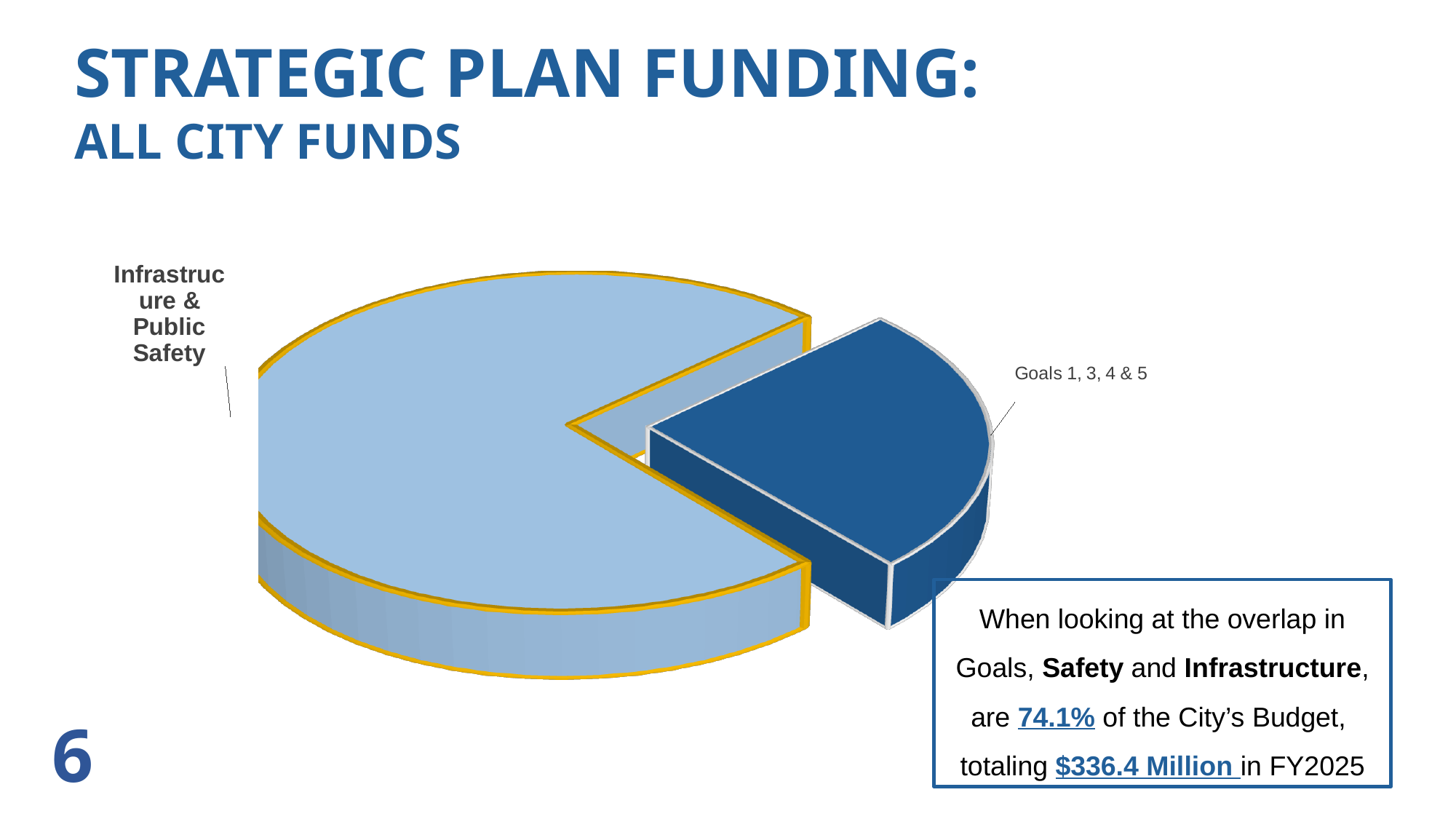
Which slice of the pie chart is the largest? Infrastructure & Public Safety Which slice is larger: Infrastructure & Public Safety or Goals 1, 3, 4 & 5? Infrastructure & Public Safety What colour is the Goals 1, 3, 4 & 5 slice of the pie chart? dark blue What kind of chart is shown on the slide? pie chart What is the title of the slide containing the pie chart? STRATEGIC PLAN FUNDING: ALL CITY FUNDS How many slices does the pie chart have? 2 According to the slide, what share of the City's Budget do Safety and Infrastructure make up? 74.1% According to the slide, what dollar amount does the Safety and Infrastructure share total in FY2025? $336.4 Million Which slice of the pie chart is the smallest? Goals 1, 3, 4 & 5